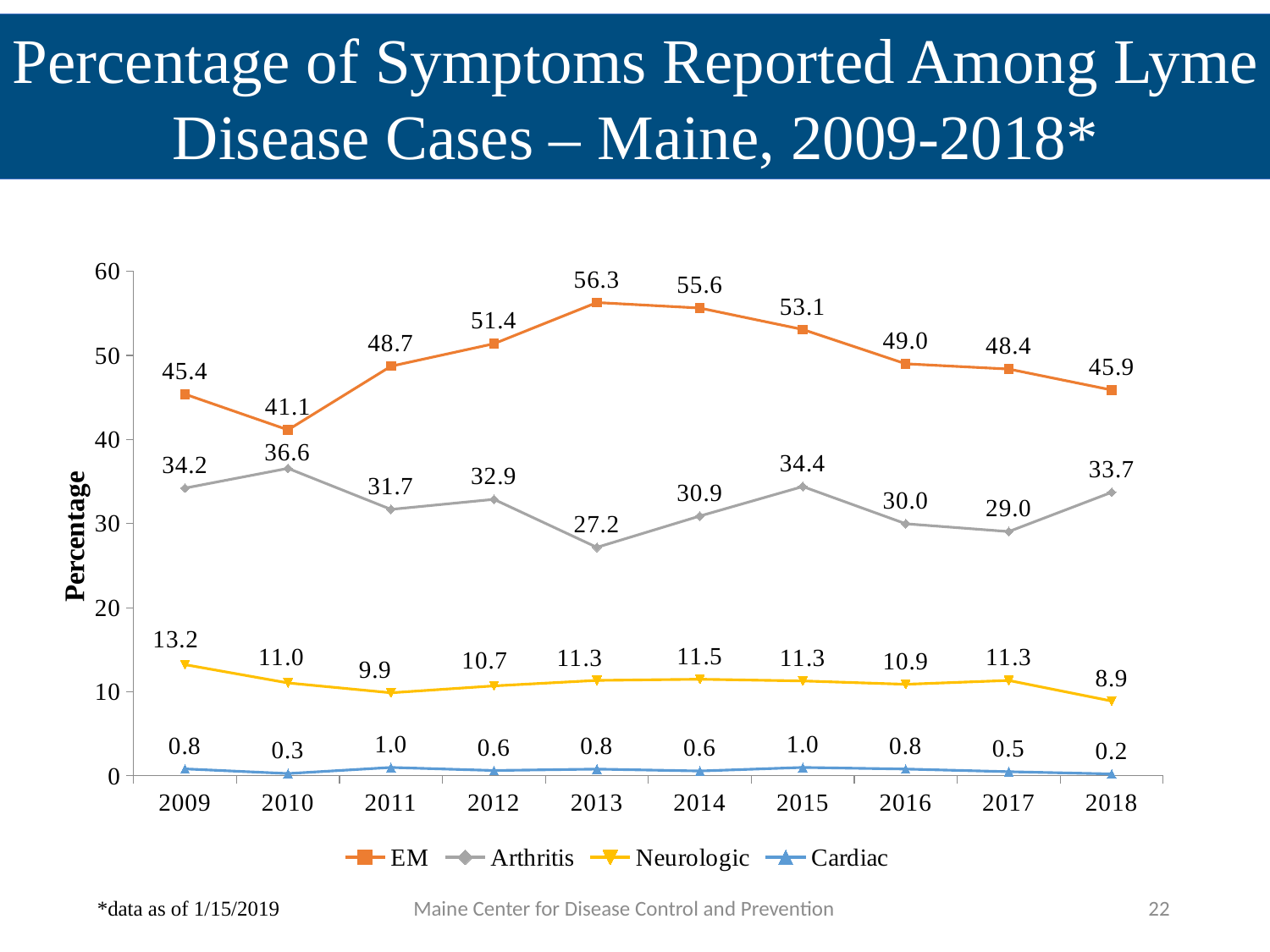
In which year was the EM percentage highest? 2013 What is the label of the y axis? Percentage Which was larger in 2015, the Arthritis percentage or the Neurologic percentage? Arthritis How many series does the legend list? 4 What was the Arthritis percentage in 2010? 36.6 In which year was the Arthritis percentage lowest? 2013 Did the EM percentage rise or fall from 2013 to 2018? Fall What was the Neurologic percentage in 2018? 8.9 What is the difference between the EM percentage in 2013 and in 2010? 15.2 What kind of chart is shown on the slide? Line chart How many years are shown on the x axis? 10 What percentage of Lyme disease cases reported EM in 2013? 56.3